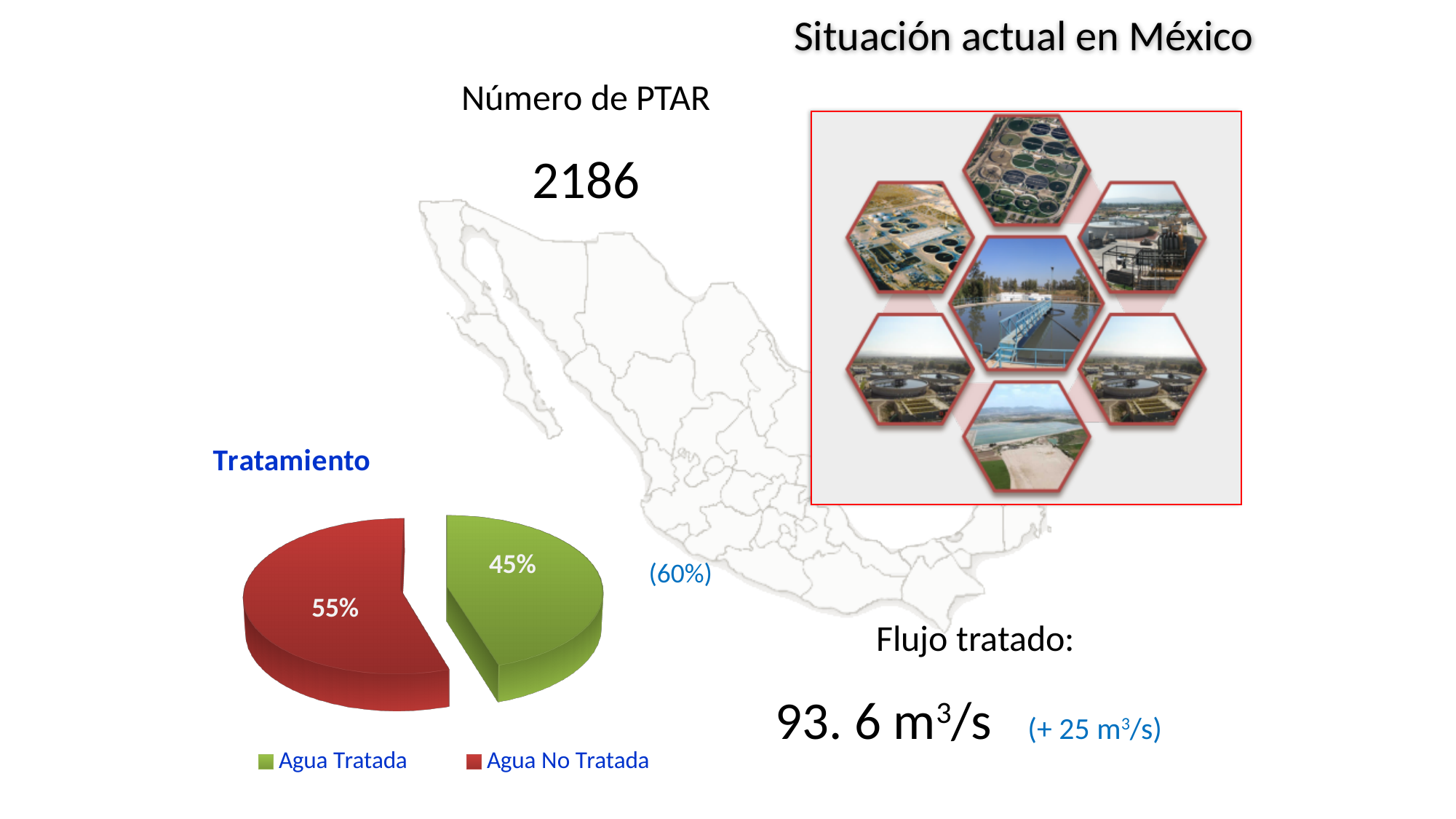
What is the value for Agua No Tratada in the 'Tratamiento' pie chart? 55% What is the value for Agua Tratada in the 'Tratamiento' pie chart? 45% Which is larger in the 'Tratamiento' pie chart, Agua Tratada or Agua No Tratada? Agua No Tratada What is the title of the pie chart on the slide? Tratamiento Which slice is the largest in the 'Tratamiento' pie chart? Agua No Tratada What colour is the Agua Tratada slice in the 'Tratamiento' pie chart? green What type of chart is the 'Tratamiento' chart? pie chart Which slice is the smallest in the 'Tratamiento' pie chart? Agua Tratada What share of the 'Tratamiento' pie does Agua Tratada represent? 45% How many slices does the 'Tratamiento' pie chart have? 2 What is the difference between the Agua No Tratada and Agua Tratada slices in the 'Tratamiento' pie chart? 10% How many entries does the legend of the 'Tratamiento' pie chart list? 2